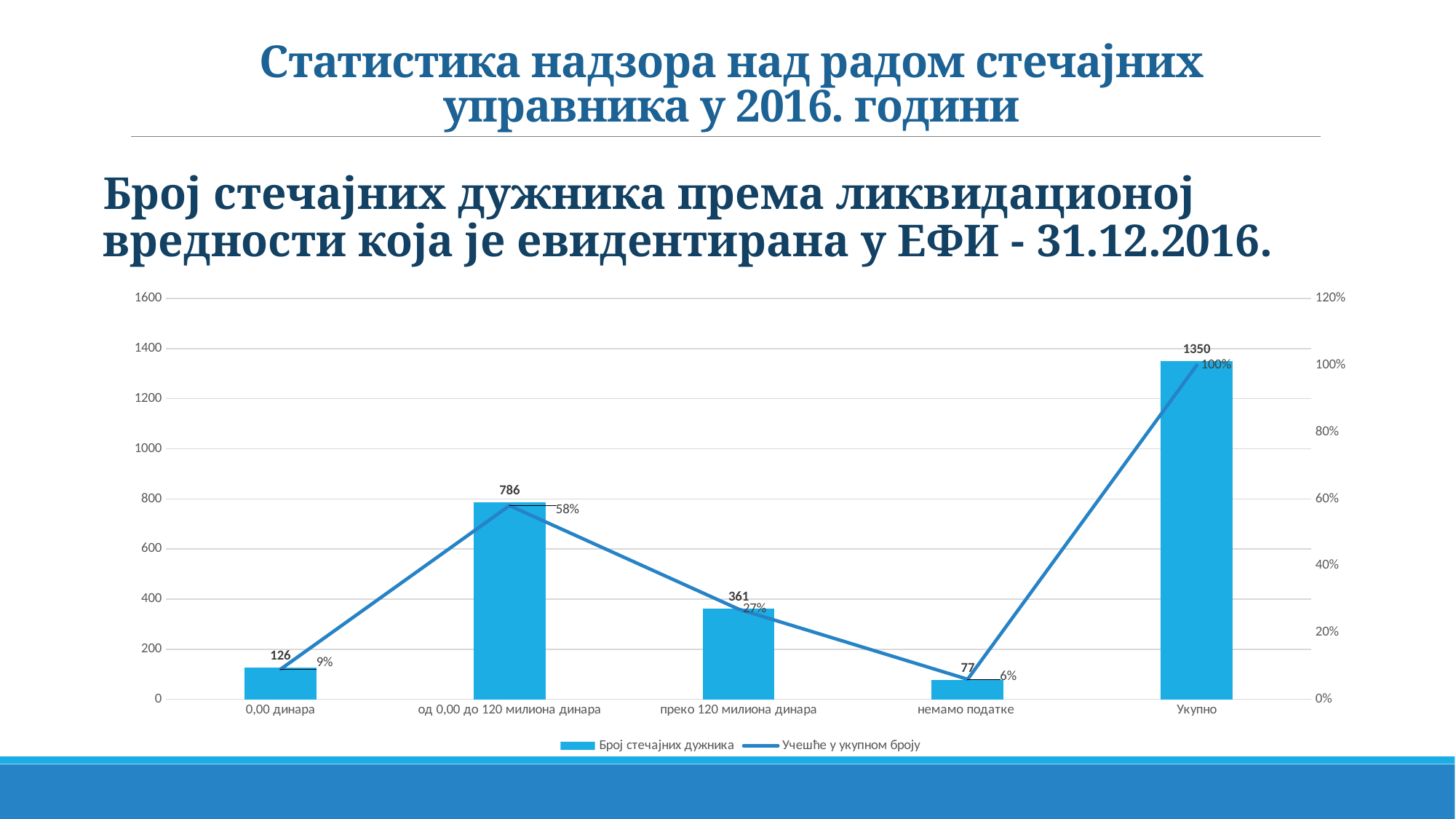
What is the 'Учешће у укупном броју' value for the category '0,00 динара'? 9% Which category has the lowest 'Број стечајних дужника'? немамо податке Which has a larger 'Број стечајних дужника': '0,00 динара' or 'немамо податке'? 0,00 динара What is the value of 'Број стечајних дужника' for the category 'немамо податке'? 77 What is the 'Учешће у укупном броју' value for the category 'преко 120 милиона динара'? 27% What kind of chart is shown on the slide? Combined bar and line chart What is the difference in 'Број стечајних дужника' between 'од 0,00 до 120 милиона динара' and 'преко 120 милиона динара'? 425 What is the 'Учешће у укупном броју' value for 'Укупно'? 100% What is the value of 'Број стечајних дужника' for the category 'од 0,00 до 120 милиона динара'? 786 Excluding 'Укупно', which category has the highest 'Број стечајних дужника'? од 0,00 до 120 милиона динара How many series does the chart legend list? 2 How many categories are shown on the x axis of the chart? 5